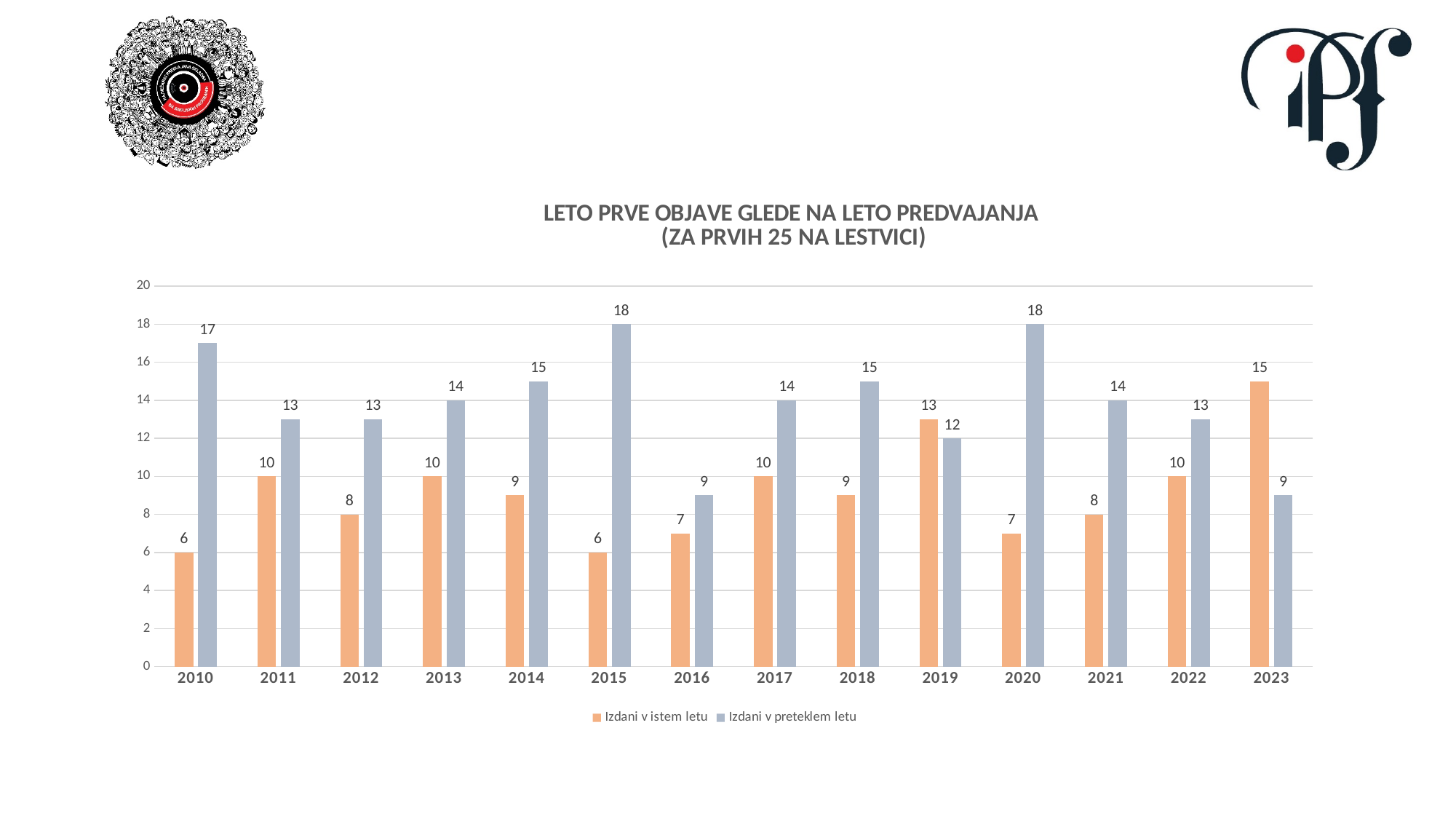
What kind of chart is shown on the slide? Bar chart What is the difference between "Izdani v preteklem letu" and "Izdani v istem letu" in 2010? 11 In which year is the value for "Izdani v istem letu" the highest? 2023 What is the title of the chart? LETO PRVE OBJAVE GLEDE NA LETO PREDVAJANJA (ZA PRVIH 25 NA LESTVICI) How many years are shown on the x axis? 14 What is the difference between "Izdani v istem letu" and "Izdani v preteklem letu" in 2023? 6 What is the value for "Izdani v preteklem letu" in 2022? 13 What is the value for "Izdani v istem letu" in 2019? 13 How many series does the legend list? 2 What is the value for "Izdani v istem letu" in 2010? 6 In 2019, which series has the larger value, "Izdani v istem letu" or "Izdani v preteklem letu"? Izdani v istem letu What is the value for "Izdani v preteklem letu" in 2015? 18